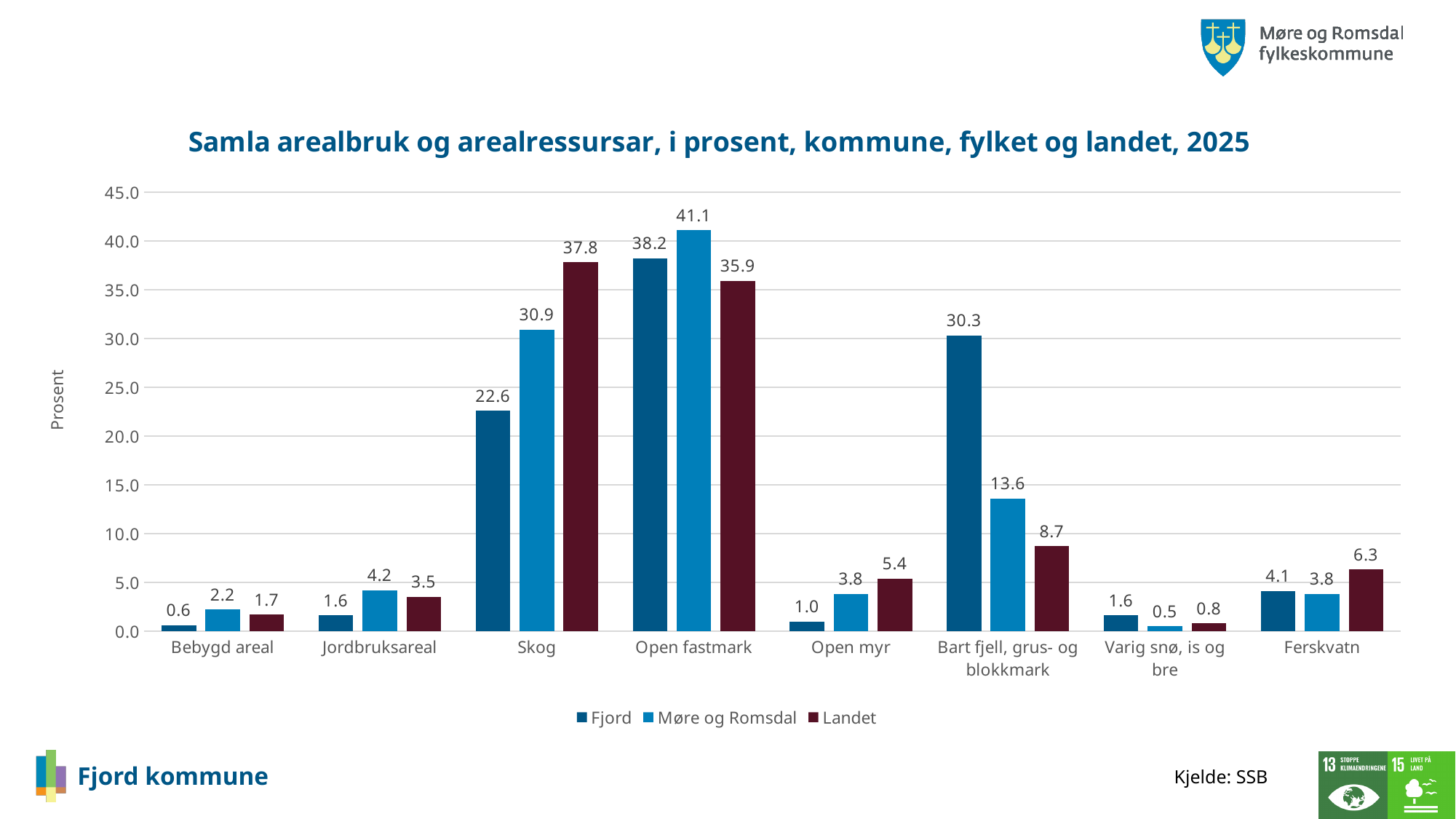
How many categories are shown on the x axis? 8 What is the label of the y axis? Prosent Which category has the highest value for Fjord? Open fastmark What is the value for Fjord in the Skog category? 22.6 How many series does the legend list? 3 Which category has the lowest value for Møre og Romsdal? Varig snø, is og bre Which is larger in the Skog category, the value for Fjord or the value for Landet? Landet What kind of chart is shown on the slide? Bar chart What is the difference between the Landet and Fjord values for Bart fjell, grus- og blokkmark? 21.6 Is the value for Møre og Romsdal in Open fastmark greater or less than 40.0? greater What is the value for Møre og Romsdal in the Bart fjell, grus- og blokkmark category? 13.6 What is the value for Landet in the Open fastmark category? 35.9